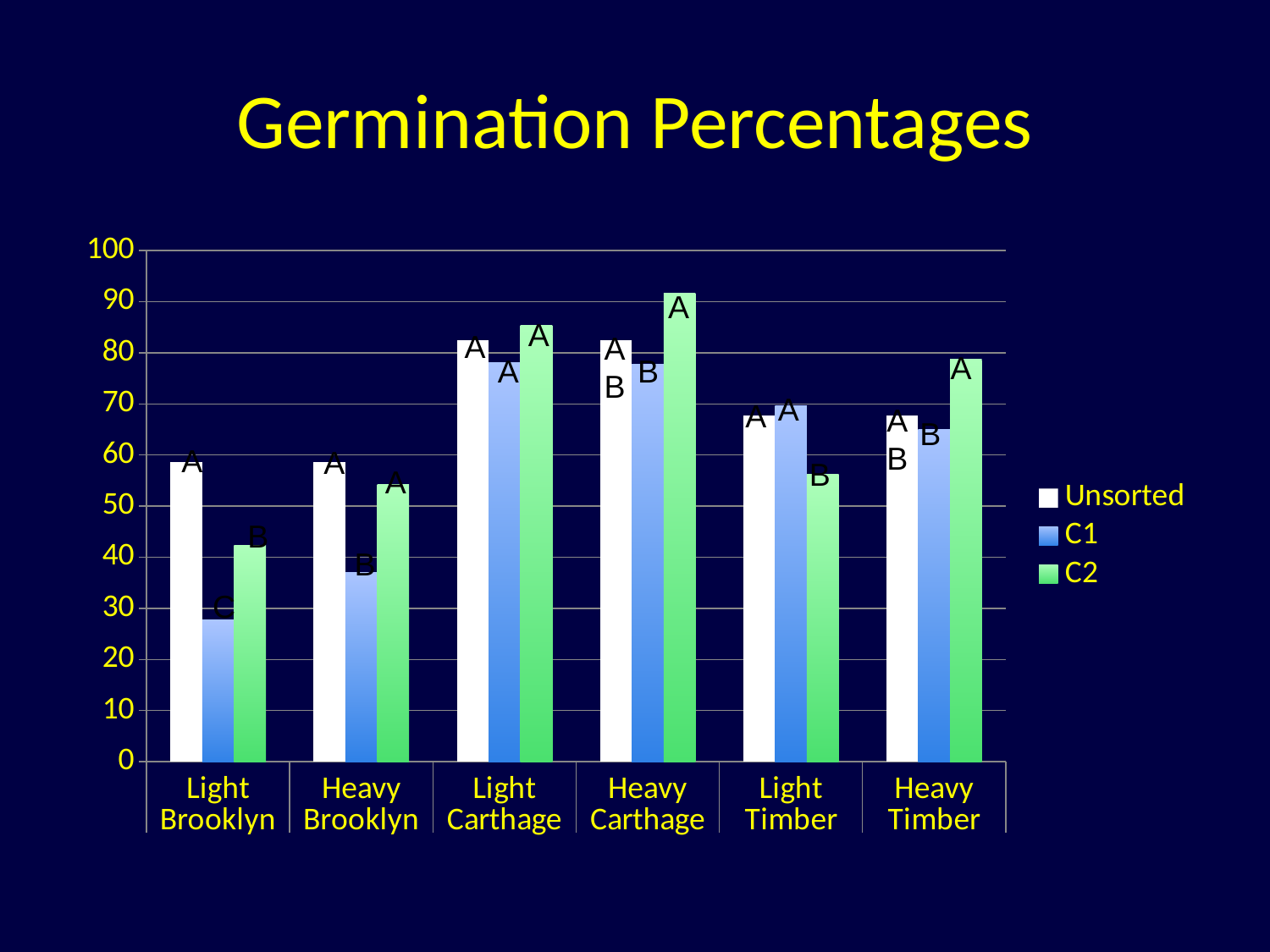
Which category has the lowest C2 bar? Light Brooklyn What kind of chart is shown on the slide? bar chart Is the C2 value for Heavy Carthage greater or less than 90? greater Is the C1 value for Light Brooklyn greater or less than 30? less Which category has the lowest C1 bar? Light Brooklyn For Heavy Timber, which is larger: the Unsorted bar or the C2 bar? C2 Is the Unsorted value for Light Carthage greater or less than 80? greater How many series does the legend list? 3 Which category has the highest C2 bar? Heavy Carthage How many categories are shown on the x axis? 6 For Light Brooklyn, which is larger: the C1 bar or the C2 bar? C2 What letter label is printed on the C1 bar for Light Brooklyn? C